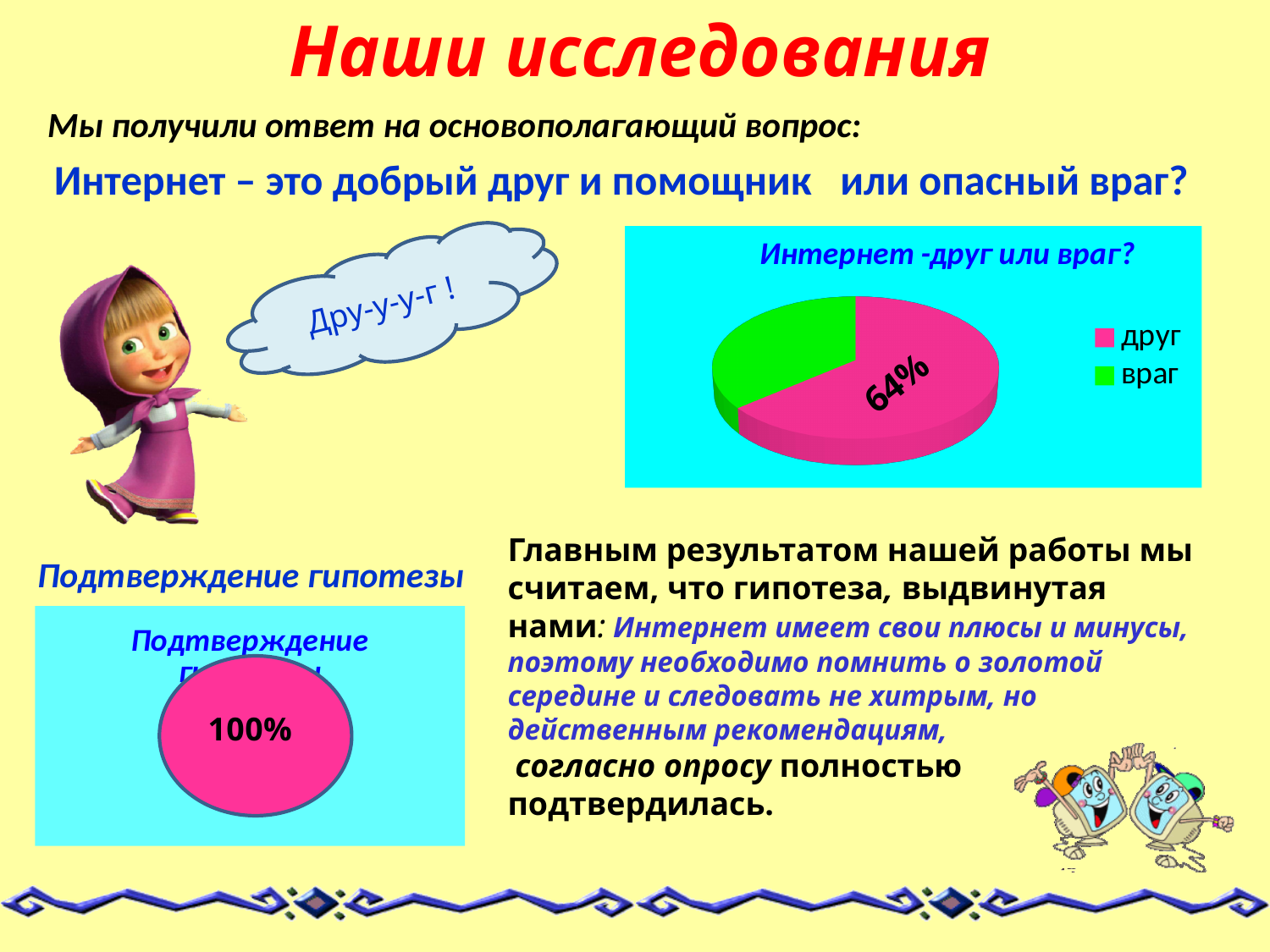
What value is printed on the "Подтверждение гипотезы" chart in the lower left of the slide? 100% In the "Интернет -друг или враг?" chart, which category has the largest slice? друг How many entries does the legend of the "Интернет -друг или враг?" chart list? 2 In the "Интернет -друг или враг?" chart, which category has the smallest slice? враг What is the title of the pie chart in the upper right of the slide? Интернет -друг или враг? How many slices does the "Интернет -друг или враг?" pie chart have? 2 What kind of chart is the "Интернет -друг или враг?" chart? pie chart What kind of chart is the "Подтверждение гипотезы" chart in the lower left of the slide? pie chart In the "Интернет -друг или враг?" chart, which slice is larger, "друг" or "враг"? друг In the "Интернет -друг или враг?" chart, what share of the pie is labelled for "друг"? 64% How many slices does the "Подтверждение гипотезы" pie chart in the lower left show? 1 In the "Интернет -друг или враг?" chart, what colour is the "враг" slice? green